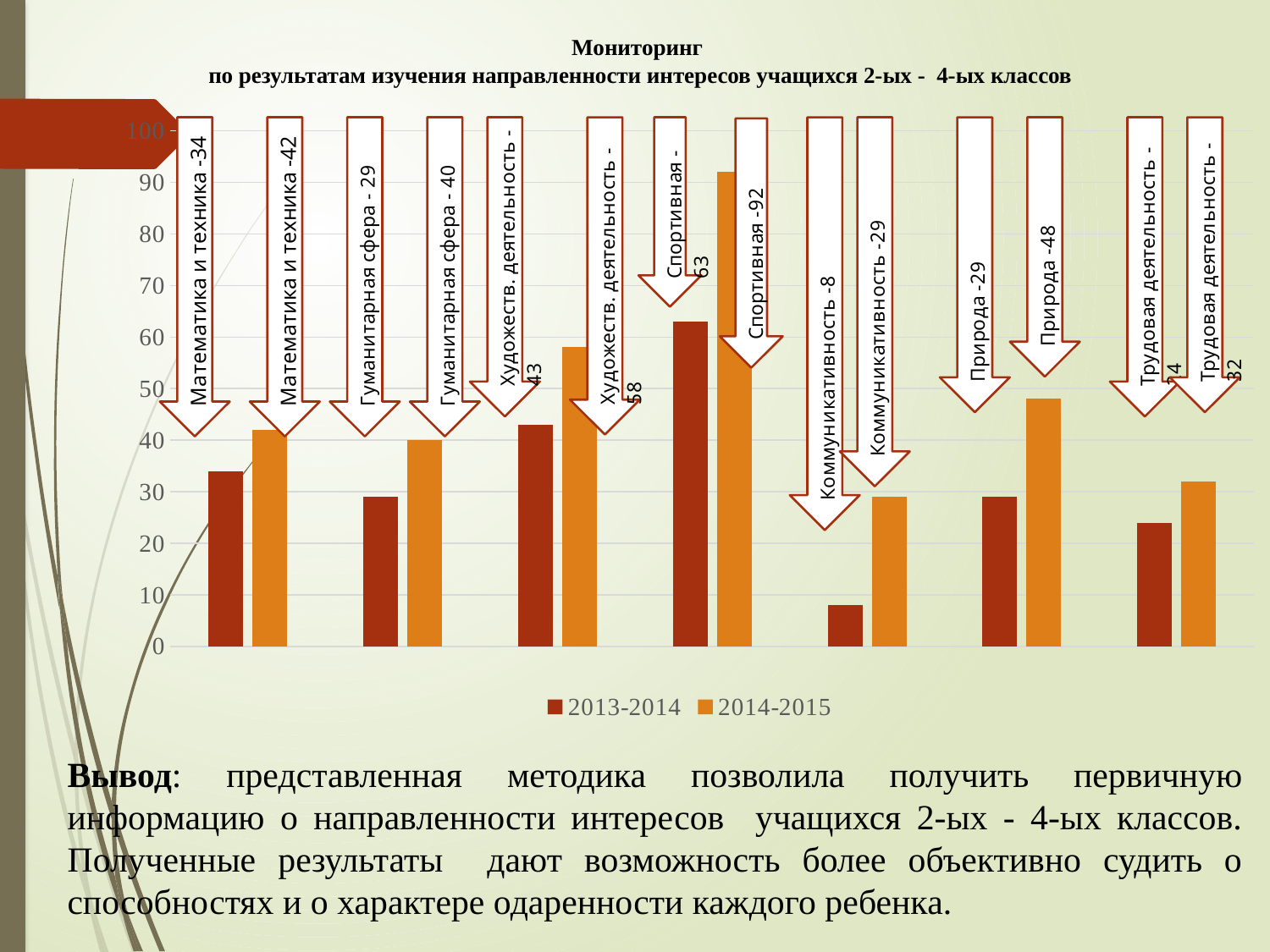
Is the 2013-2014 value for Трудовая деятельность greater or less than 30? less How many categories (interest areas) are plotted on the chart? 7 What is the difference between the 2014-2015 and 2013-2014 values for Математика и техника? 8 What kind of chart is shown on the slide? bar chart What is the value for Природа in 2014-2015? 48 What are the two series named in the legend? 2013-2014 and 2014-2015 Which is larger in 2014-2015: Природа or Гуманитарная сфера? Природа Which category has the lowest value in the 2013-2014 series? Коммуникативность What is the value for Спортивная in 2014-2015? 92 What is the value for Коммуникативность in 2013-2014? 8 How many series does the legend list? 2 Which category has the highest value in the 2014-2015 series? Спортивная